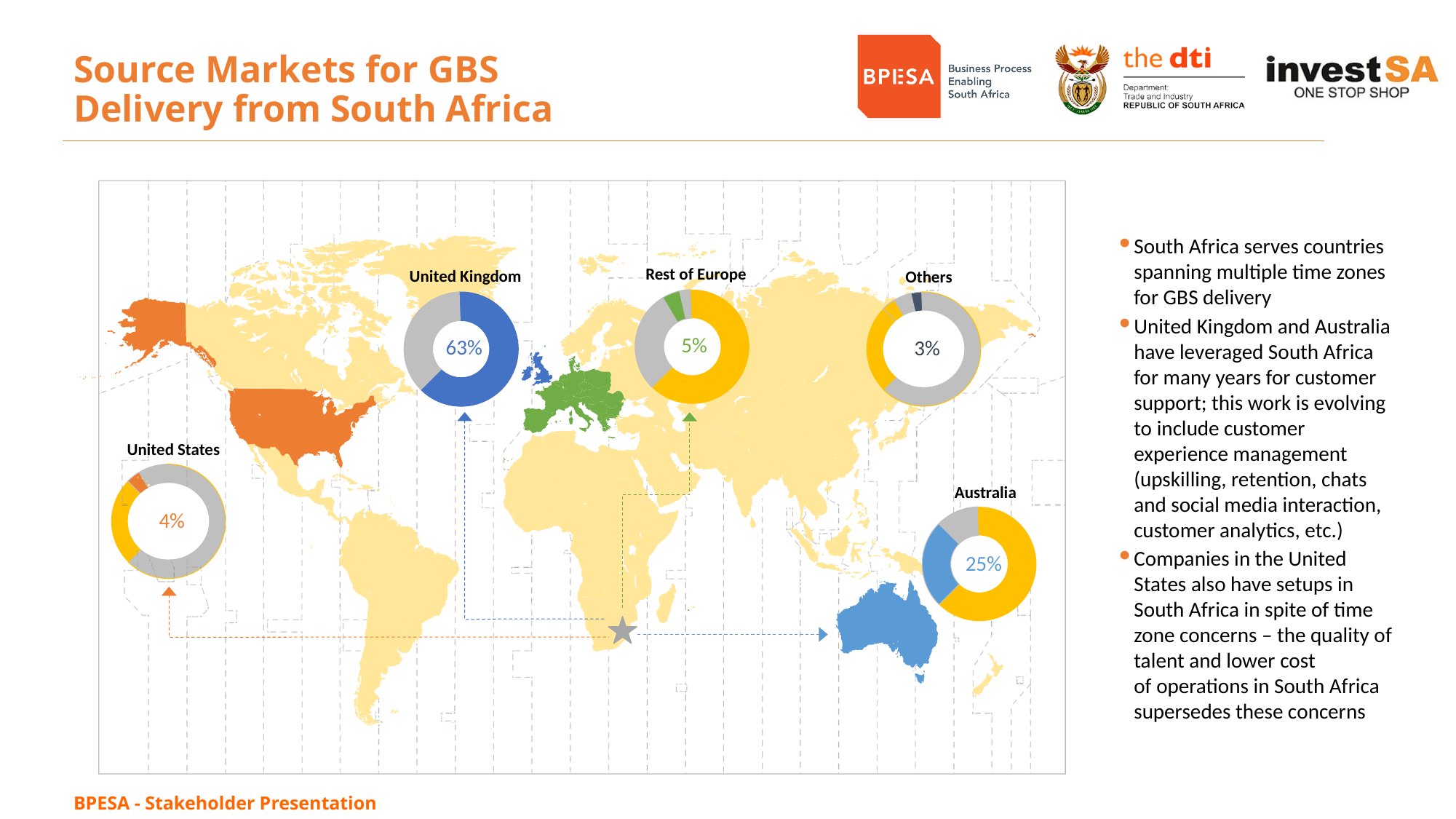
What kind of chart is used to show each source market's percentage on the map? Donut (pie) chart What is the combined percentage of the United States and Others donut charts? 7% Which has the larger percentage on its donut chart, Rest of Europe or United States? Rest of Europe On the Rest of Europe donut chart, what percentage is shown in the centre? 5% On the United States donut chart, what percentage is shown in the centre? 4% How many donut charts are placed on the map? 5 What is the difference between the United Kingdom percentage and the Australia percentage shown on the donut charts? 38% On the Others donut chart, what percentage is shown in the centre? 3% Across the donut charts on the map, which source market has the lowest percentage? Others On the Australia donut chart, what percentage is shown in the centre? 25% On the United Kingdom donut chart, what percentage is shown in the centre? 63% Across the donut charts on the map, which source market has the highest percentage? United Kingdom